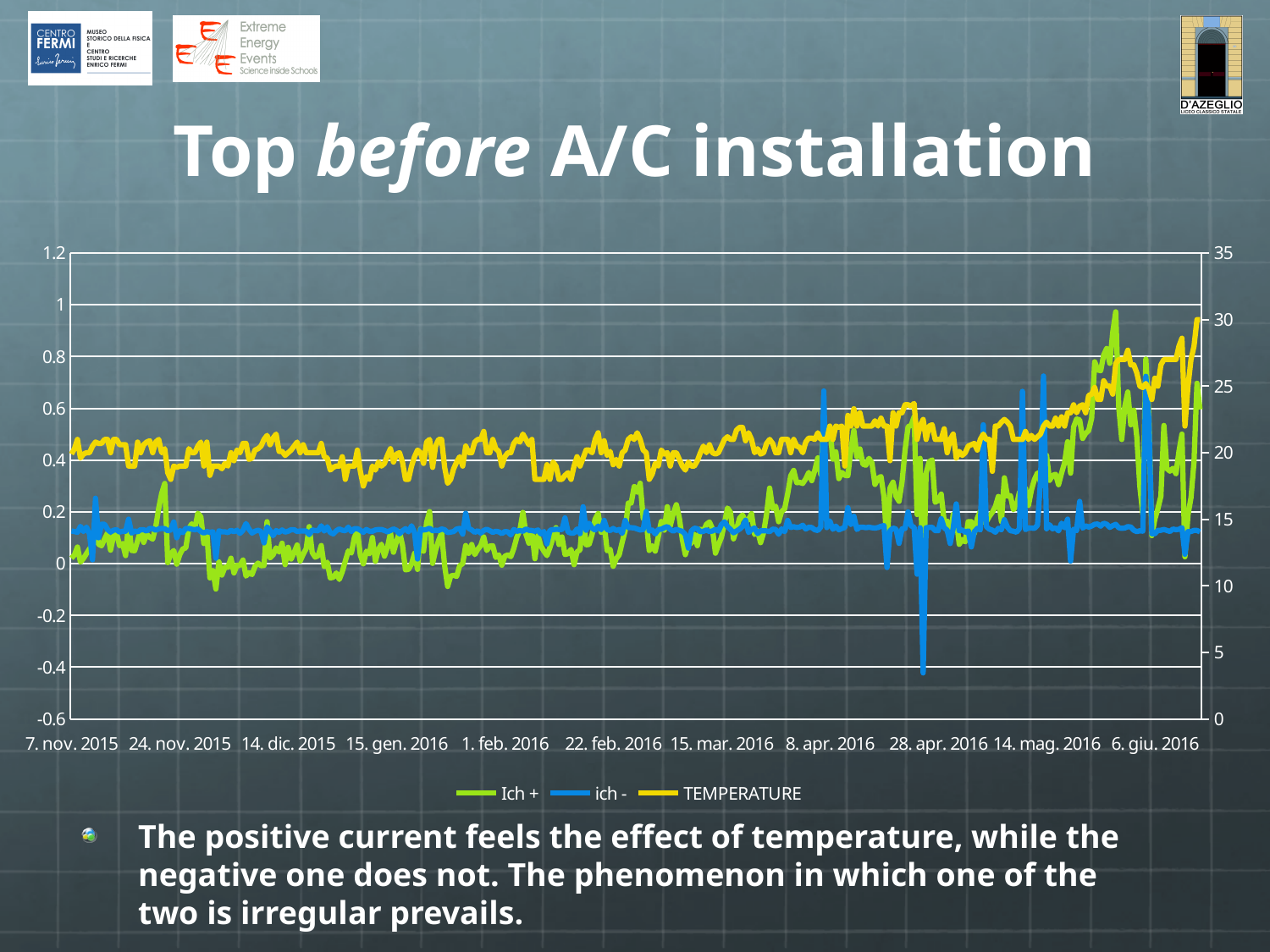
Is the value for Ich + at 6. giu. 2016 greater or less than 0.4? less How many date labels are shown along the x axis? 11 Is the value for ich - at 7. nov. 2015 greater or less than 0.4? less Is the value for Ich + at 7. nov. 2015 greater or less than 0.2? less What are the three series named in the legend? Ich +, ich -, TEMPERATURE What kind of chart is shown on the slide? line chart Which of Ich + or ich - reaches the higher peak value on the left axis? Ich + How many series does the legend list? 3 What is the title of the slide containing the chart? Top before A/C installation Which of Ich + or ich - reaches the lowest value on the left axis? ich - Does the Ich + series generally rise or fall from 7. nov. 2015 to 6. giu. 2016? rise